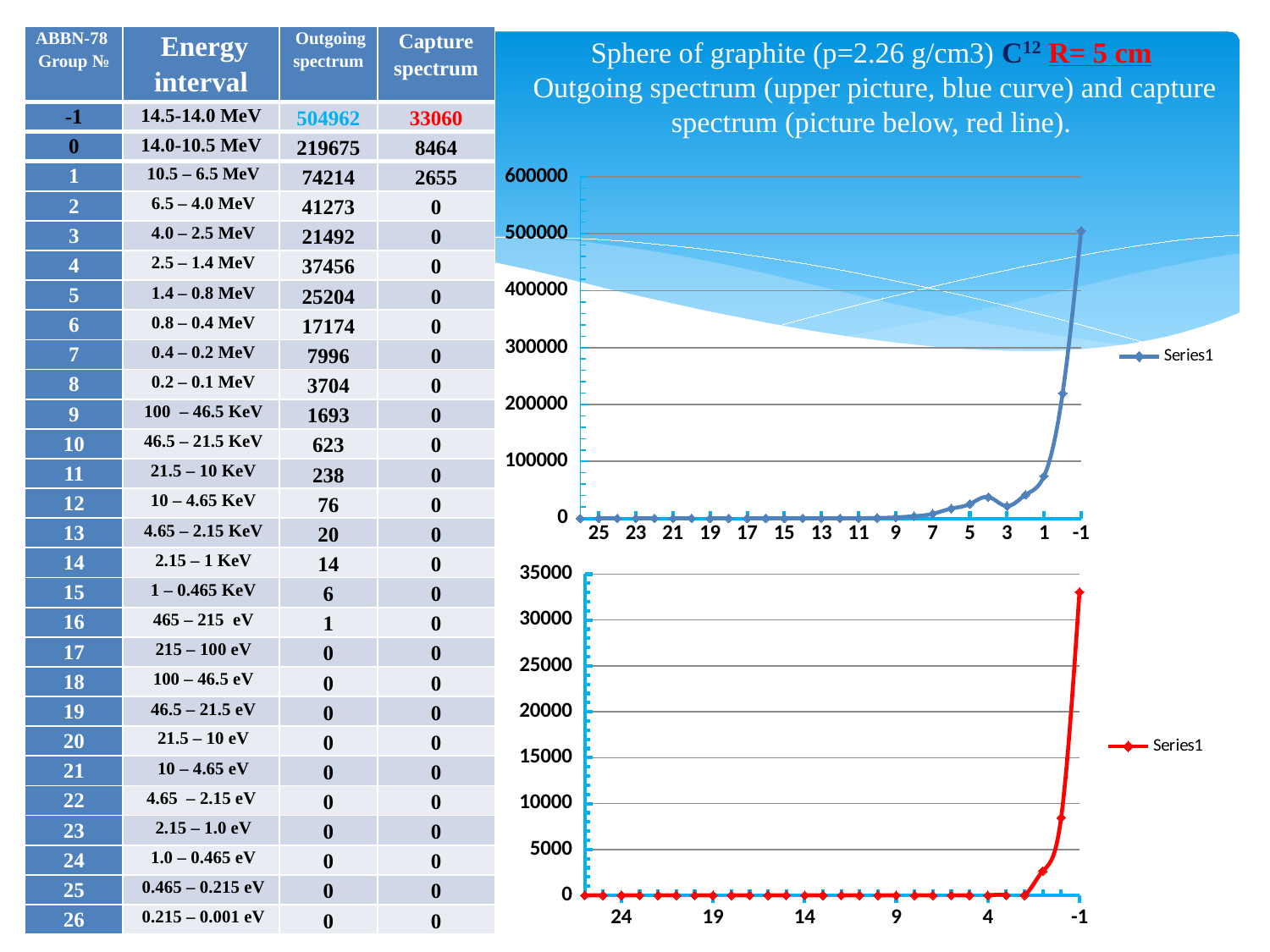
What kind of chart is the upper chart on the slide? line chart What kind of chart is the lower chart on the slide? line chart In the upper chart, at which group number on the x axis does the curve reach its highest value? -1 What is the highest tick value shown on the y axis of the lower chart? 35000 In the upper chart, is the value at group -1 greater or less than 400000? greater In the upper chart, is the value at group 0 greater or less than 100000? greater In the lower chart, is the value at group 0 greater or less than 10000? less In the upper chart, do the values rise or fall moving from left (group 25) to right (group -1) along the x axis? rise What is the legend entry shown for the lower chart? Series1 How many series does the legend of the upper chart list? 1 In the lower chart, at which group number on the x axis does the red line reach its highest value? -1